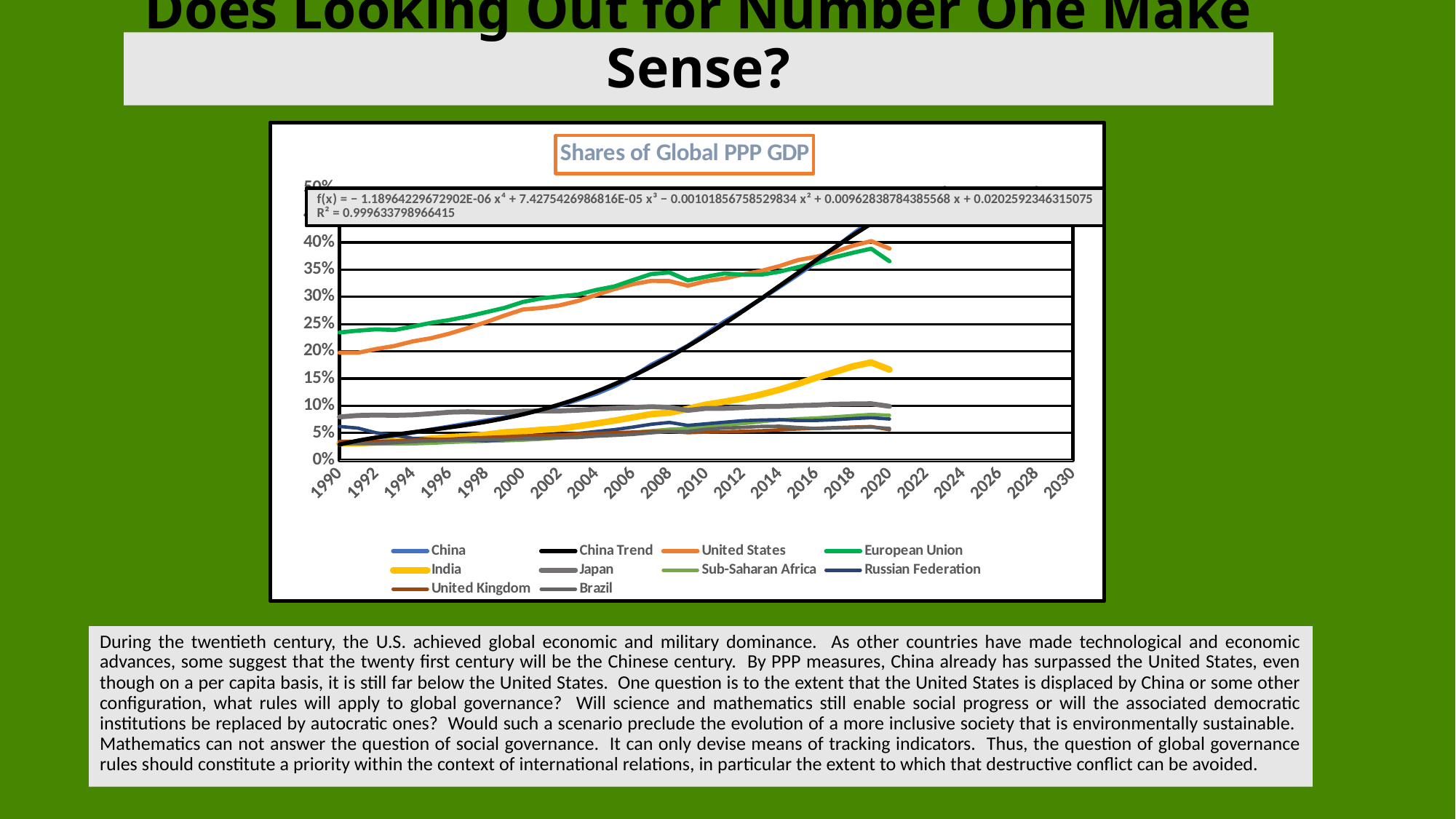
Does the China series rise or fall from 1990 to 2020? Rises How many series does the chart legend list? 10 Does the United States series rise or fall from 1990 to 2018? Rises What colour is the China Trend line in the chart? Black What is the title of the chart? Shares of Global PPP GDP Is the value for the Russian Federation in 2020 greater or less than 10%? less Is the value for Japan in 2010 greater or less than 15%? less What kind of chart is shown on the slide? Line chart In 2020, which is larger: the India share or the Japan share? India Is the value for the United States in 1990 greater or less than 25%? less In 1990, which is larger: the European Union share or the United States share? European Union